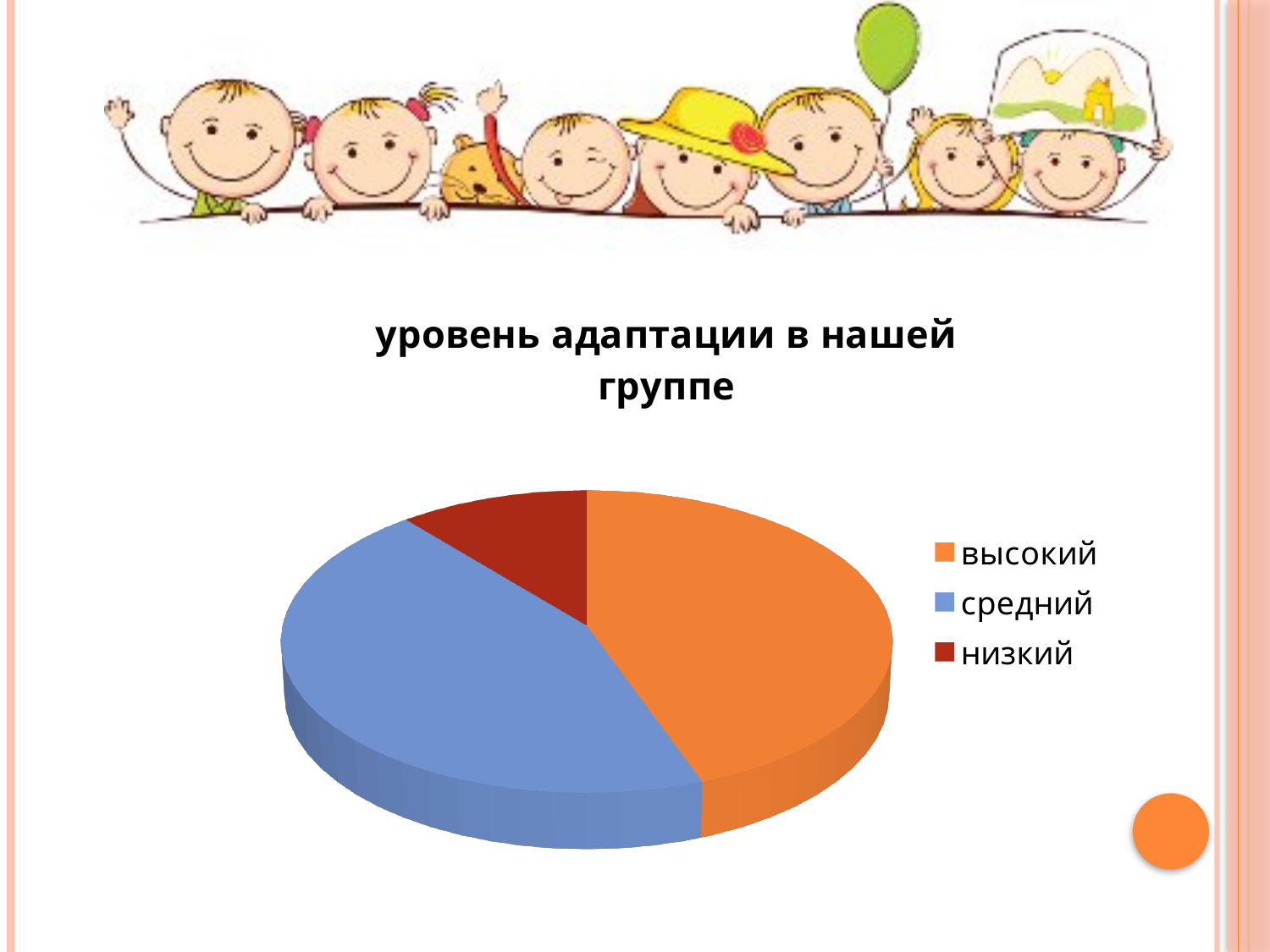
What kind of chart is shown on the slide? pie chart Which slice is larger, средний or низкий? средний How many slices does the pie chart have? 3 Which category has the smallest slice of the pie? низкий Which colour represents the category низкий in the chart? dark red Which slice is larger, высокий or низкий? высокий What is the title of the chart? уровень адаптации в нашей группе How many entries does the legend list? 3